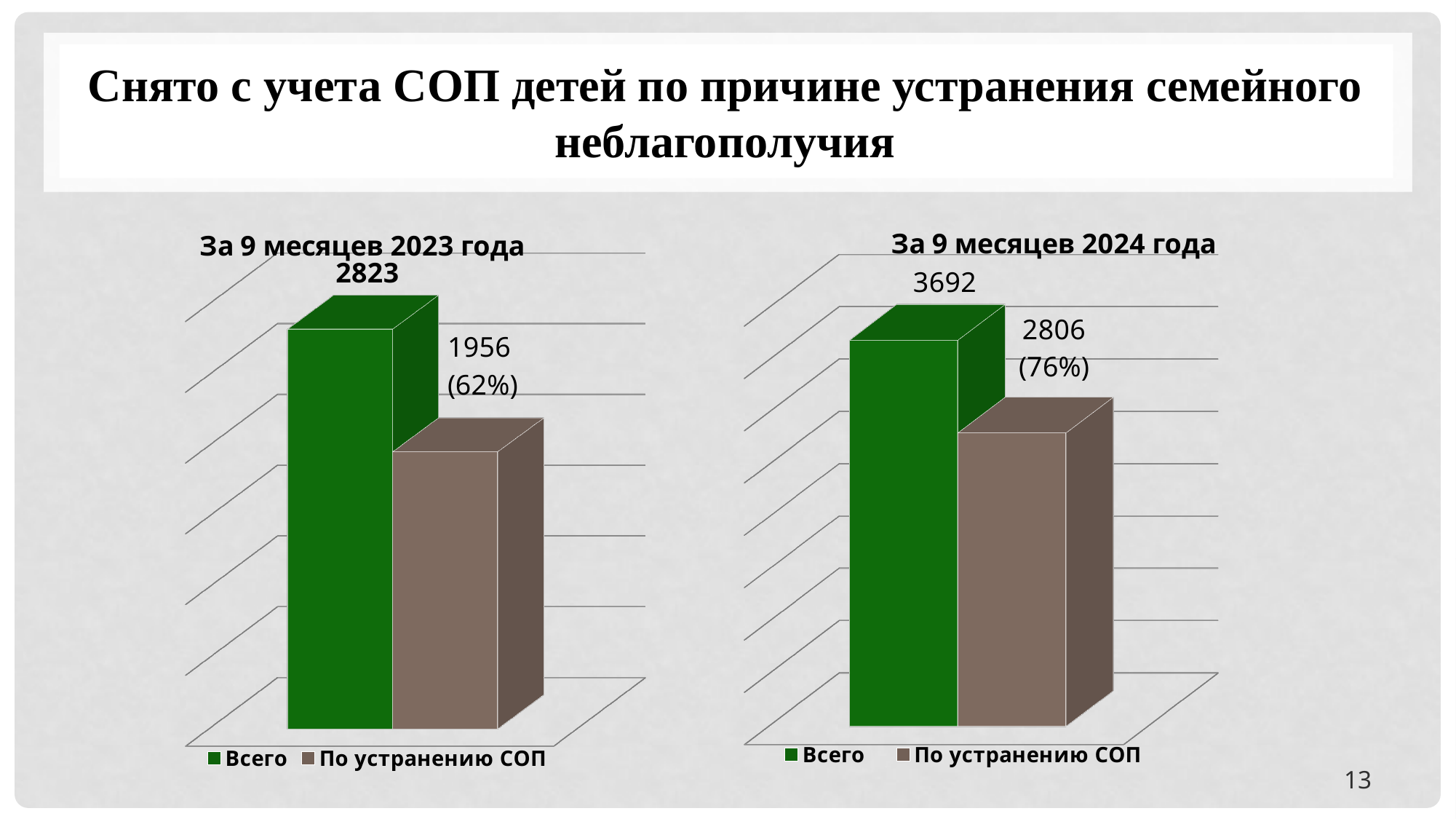
In the chart titled 'За 9 месяцев 2024 года', what is the value for 'По устранению СОП'? 2806 In the chart titled 'За 9 месяцев 2023 года', what is the value for 'По устранению СОП'? 1956 In the chart titled 'За 9 месяцев 2024 года', which series has the higher value, 'Всего' or 'По устранению СОП'? Всего In the chart titled 'За 9 месяцев 2024 года', what percentage is shown next to the 'По устранению СОП' value? 76% In the chart titled 'За 9 месяцев 2023 года', what percentage is shown next to the 'По устранению СОП' value? 62% In the chart titled 'За 9 месяцев 2024 года', what is the value for 'Всего'? 3692 How many series does the legend of the chart titled 'За 9 месяцев 2023 года' list? 2 In the chart titled 'За 9 месяцев 2023 года', what is the difference between 'Всего' and 'По устранению СОП'? 867 What kind of chart is the chart titled 'За 9 месяцев 2024 года'? Bar chart In the chart titled 'За 9 месяцев 2023 года', what colour is the 'Всего' bar? Green In the chart titled 'За 9 месяцев 2024 года', what is the difference between 'Всего' and 'По устранению СОП'? 886 In the chart titled 'За 9 месяцев 2023 года', what is the value for 'Всего'? 2823